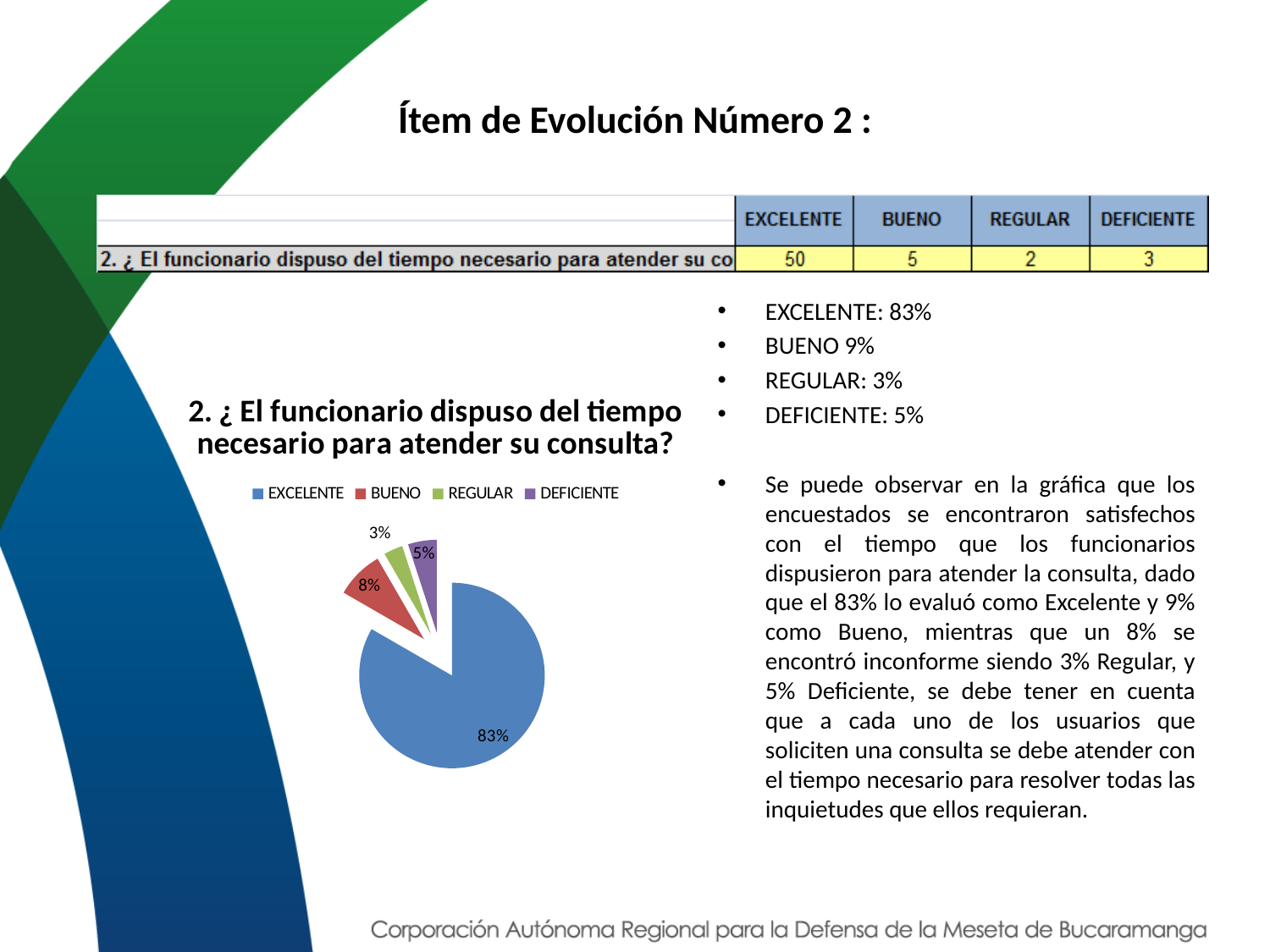
What percentage does the BUENO slice show in the pie chart? 8% Which category has the largest slice in the pie chart? EXCELENTE What is the difference in percentage points between the EXCELENTE and BUENO slices? 75 Which category has the smallest slice in the pie chart? REGULAR What percentage does the DEFICIENTE slice show in the pie chart? 5% What percentage does the EXCELENTE slice show in the pie chart? 83% What kind of chart is shown on the slide? pie chart Which slice is larger in the pie chart, BUENO or DEFICIENTE? BUENO What colour is the EXCELENTE slice in the pie chart? blue What is the title of the pie chart? 2. ¿ El funcionario dispuso del tiempo necesario para atender su consulta? What percentage does the REGULAR slice show in the pie chart? 3% How many categories does the pie chart legend list? 4